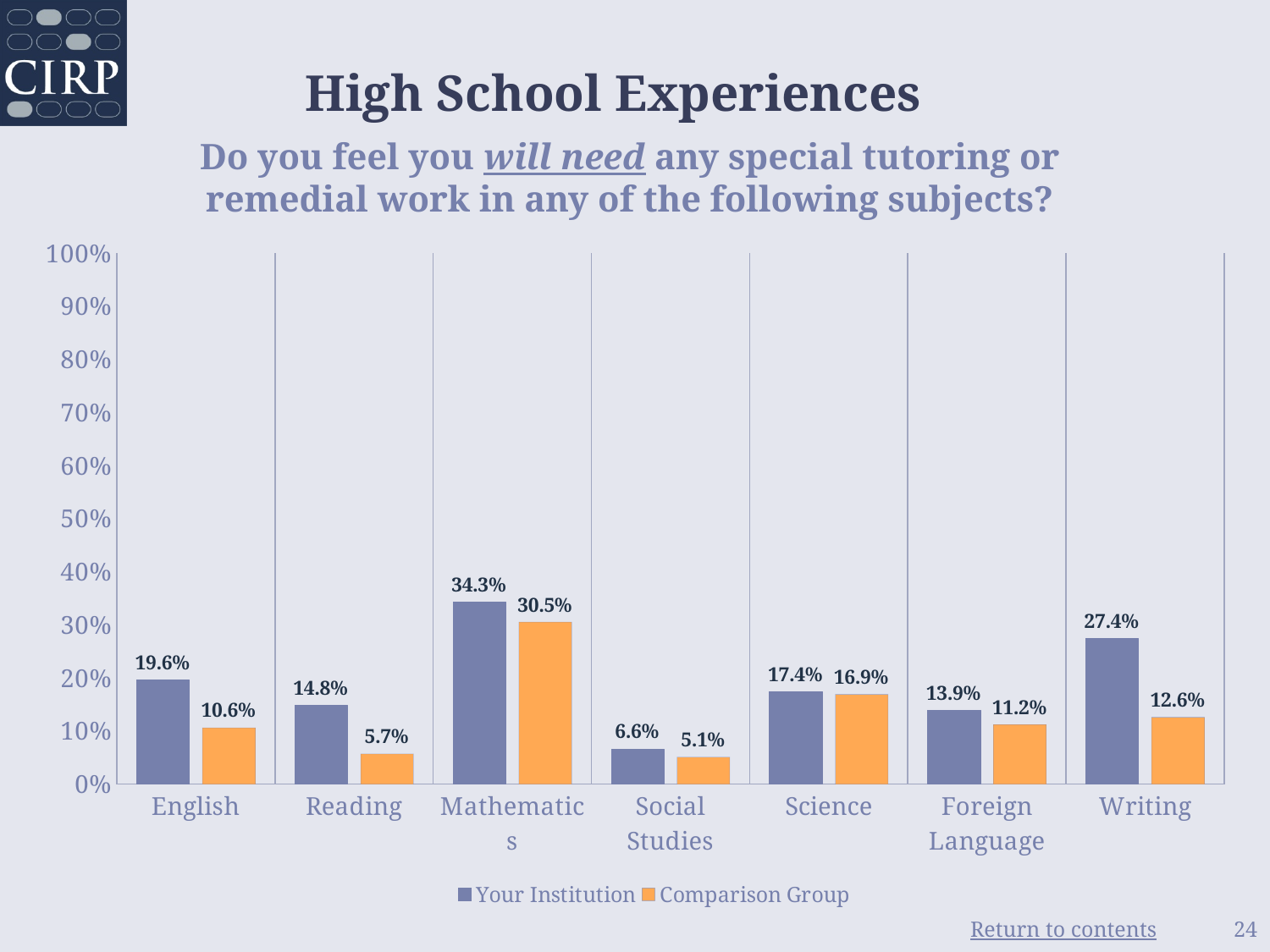
What is the value for Your Institution in Mathematics? 34.3% Is the Comparison Group value for Mathematics greater or less than 20%? greater What is the difference between Your Institution and the Comparison Group for English? 9.0% Which subject has the highest value for Your Institution? Mathematics Which is larger for Foreign Language: Your Institution or the Comparison Group? Your Institution What is the difference between Your Institution and the Comparison Group for Writing? 14.8% What kind of chart is shown on the slide? Bar chart What is the value for Your Institution in Writing? 27.4% How many subjects are shown on the x axis? 7 How many series does the legend list? 2 Which subject has the lowest value for the Comparison Group? Social Studies What is the value for the Comparison Group in Reading? 5.7%